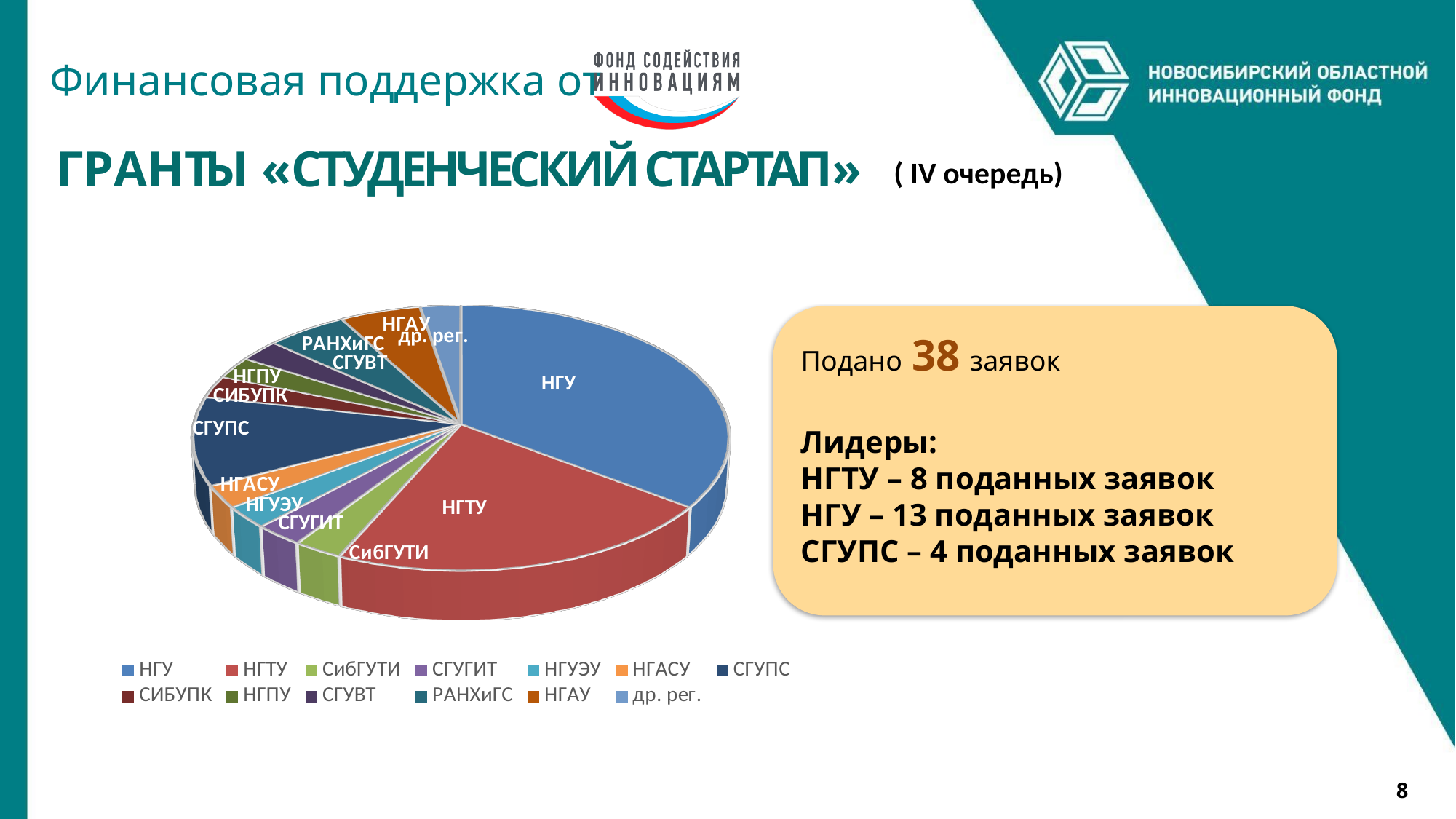
Which slice is larger in the pie chart: НГТУ or СГУПС? НГТУ How many applications were submitted by НГТУ according to the slide? 8 What kind of chart is shown on the slide? pie chart Which slice is larger in the pie chart: НГУ or НГТУ? НГУ How many categories does the pie chart's legend list? 13 Which three organisations are named as leaders (Лидеры) on the slide? НГТУ, НГУ, СГУПС Which category has the largest slice of the pie chart? НГУ How many applications were submitted by НГУ according to the slide? 13 What is the difference between the number of applications from НГУ and from НГТУ? 5 What is the total number of applications submitted (Подано ... заявок)? 38 How many applications were submitted by СГУПС according to the slide? 4 What is the last legend entry of the pie chart? др. рег.